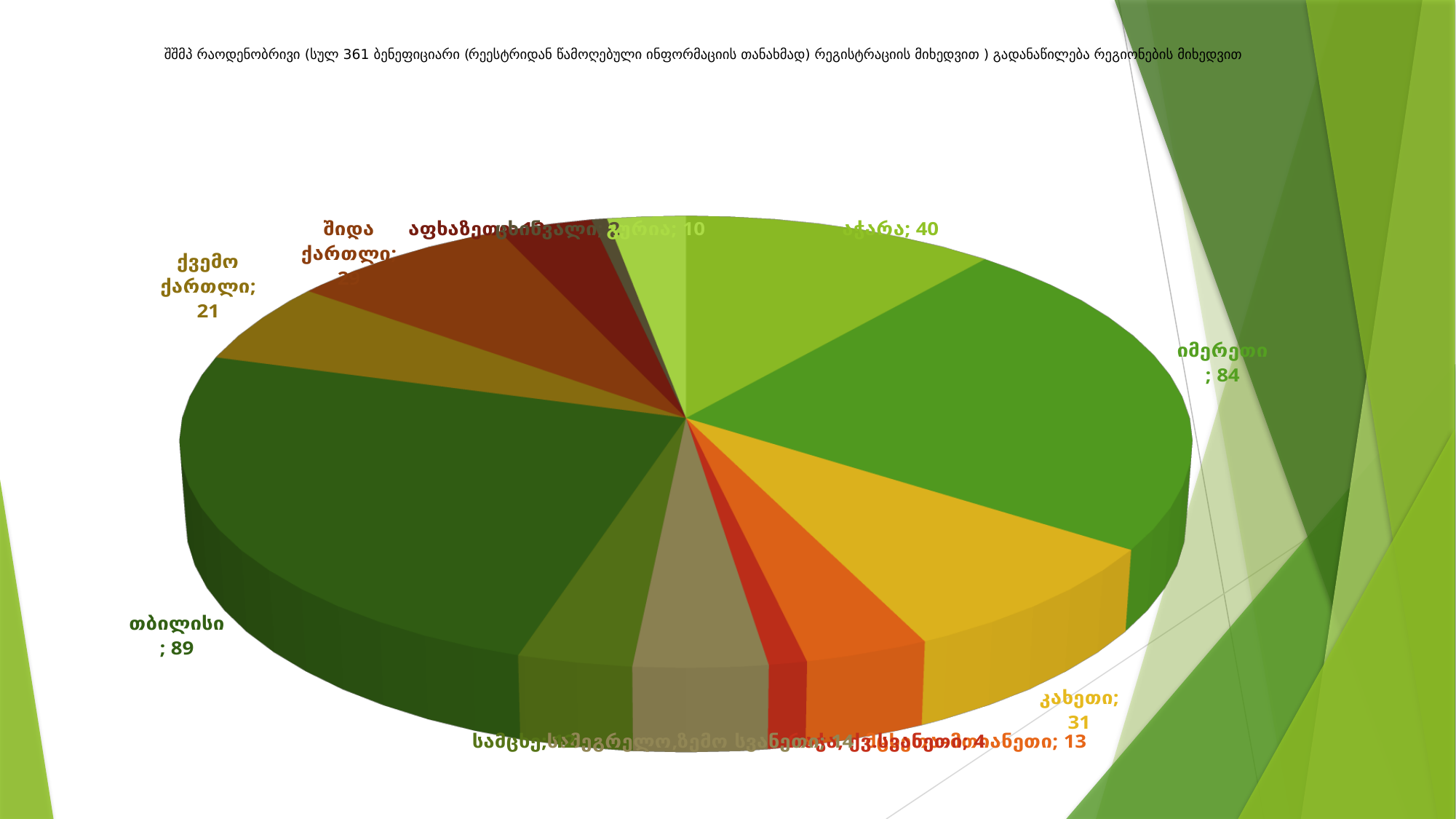
What is the value for გურია in the pie chart? 10 Which region has the largest slice in the pie chart? თბილისი According to the chart title, how many beneficiaries are there in total? 361 What is the value for თბილისი in the pie chart? 89 What is the difference between the values for თბილისი and იმერეთი? 5 Which is larger, the value for კახეთი or the value for ქვემო ქართლი? კახეთი What kind of chart is shown on the slide? Pie chart What is the value for კახეთი in the pie chart? 31 Which is larger, the value for თბილისი or the value for იმერეთი? თბილისი What is the value for ქვემო ქართლი in the pie chart? 21 What is the difference between the values for თბილისი and კახეთი? 58 What is the value for იმერეთი in the pie chart? 84